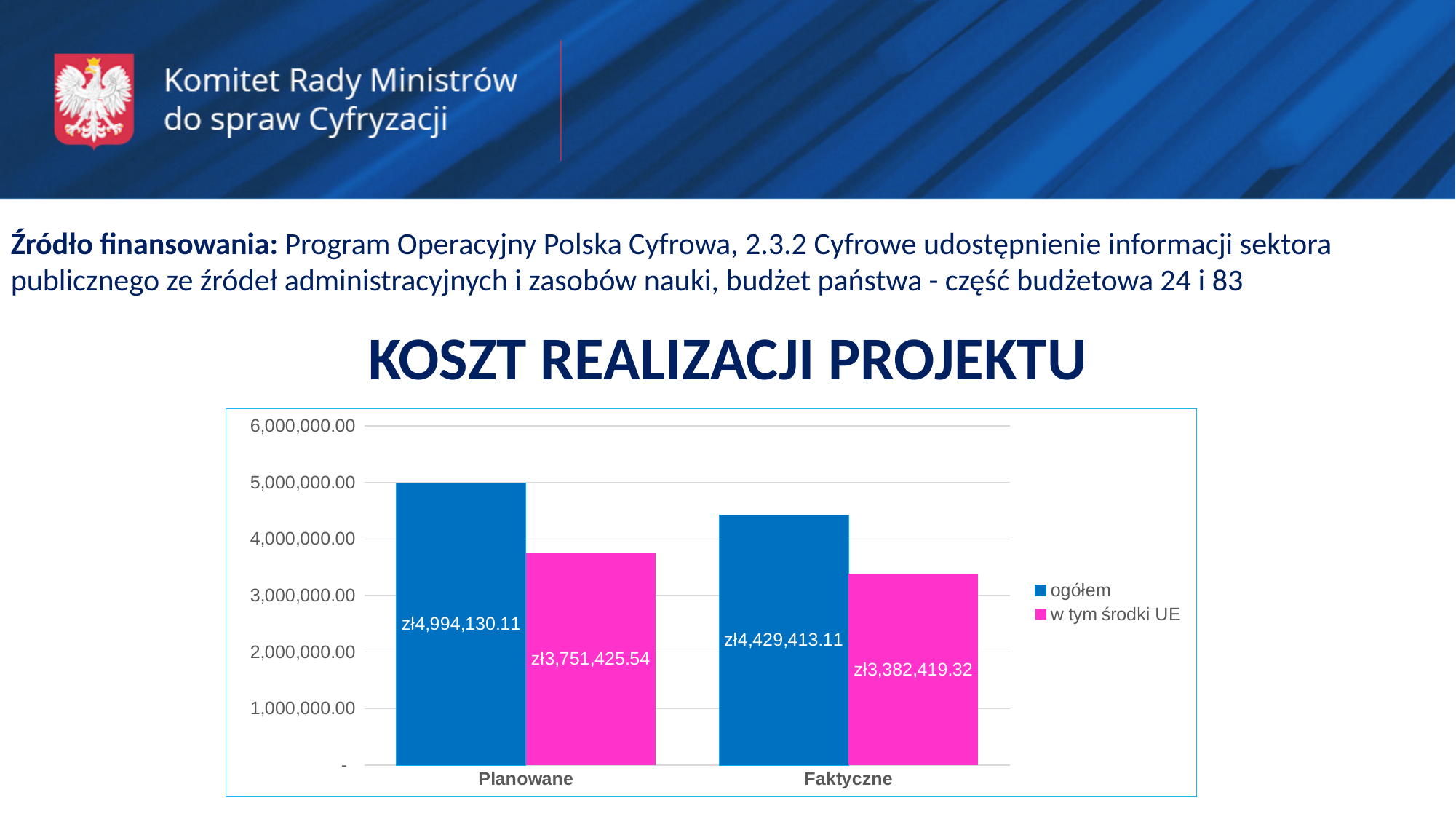
How many categories are shown on the x axis of the chart? 2 What is the value of the 'w tym środki UE' bar for Faktyczne? zł3,382,419.32 How many series does the chart legend list? 2 Which bar in the chart has the highest value? ogółem for Planowane Is the 'w tym środki UE' value for Planowane larger or smaller than the 'w tym środki UE' value for Faktyczne? larger What is the value of the 'ogółem' bar for Planowane? zł4,994,130.11 Which bar in the chart has the lowest value? w tym środki UE for Faktyczne What type of chart is shown on the slide? bar chart What is the value of the 'w tym środki UE' bar for Planowane? zł3,751,425.54 What is the difference between the 'ogółem' and 'w tym środki UE' values for Faktyczne? zł1,046,993.79 What is the value of the 'ogółem' bar for Faktyczne? zł4,429,413.11 What is the difference between the 'ogółem' values for Planowane and Faktyczne? zł564,717.00